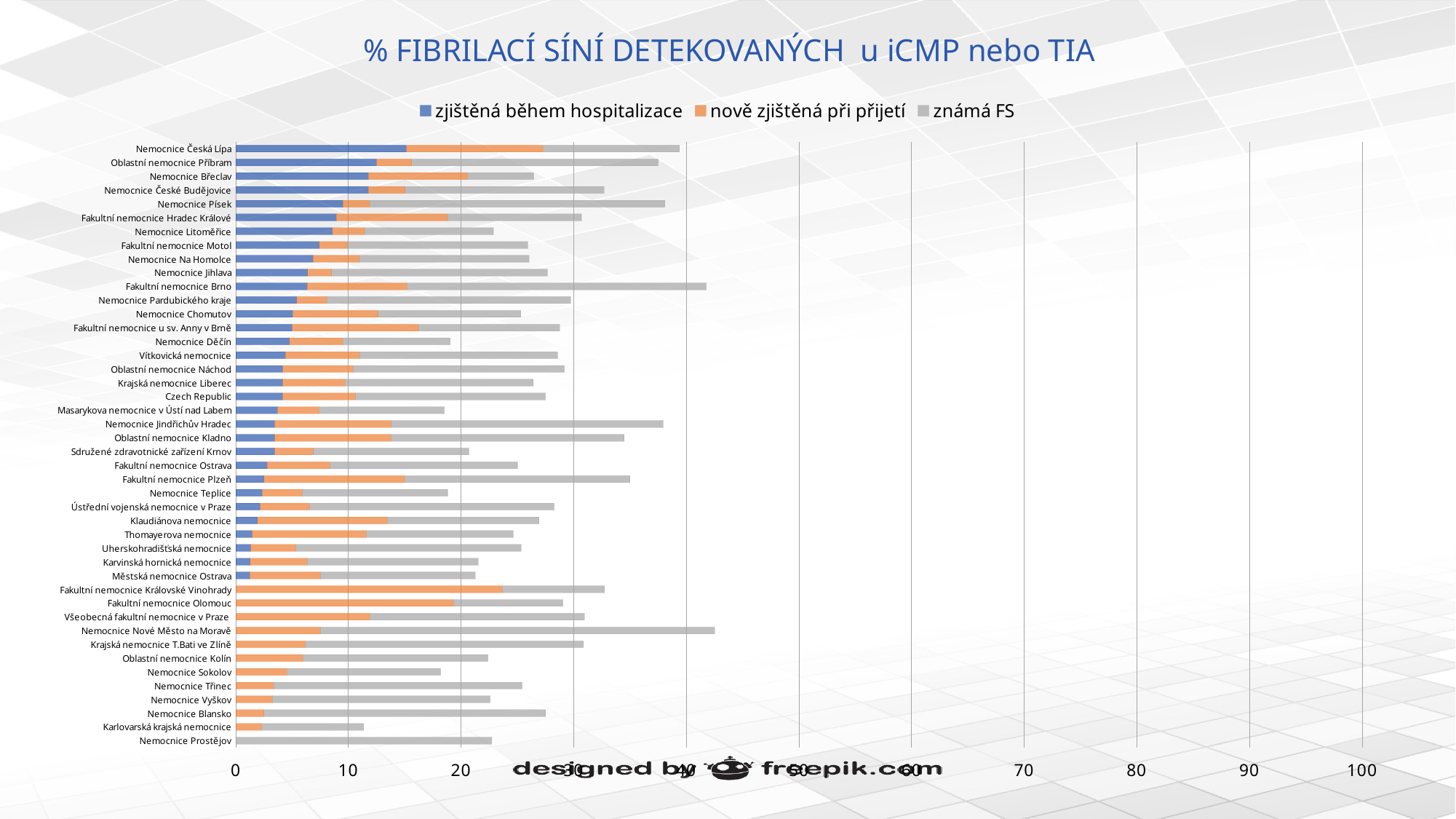
Is the blue 'zjištěná během hospitalizace' value for Nemocnice Česká Lípa greater or less than 10? greater Which category has the shortest total bar? Karlovarská krajská nemocnice Which has the longer total bar, Nemocnice Česká Lípa or Nemocnice Děčín? Nemocnice Česká Lípa What kind of chart is shown on the slide? Bar chart How many series does the legend list? 3 Is the total bar for Fakultní nemocnice Brno greater or less than 40? greater Which category has the longest blue 'zjištěná během hospitalizace' segment? Nemocnice Česká Lípa Is the total bar for Karlovarská krajská nemocnice greater or less than 20? less What is the title of the chart? % FIBRILACÍ SÍNÍ DETEKOVANÝCH u iCMP nebo TIA Which series is shown in grey in the legend? známá FS How many hospitals (categories) are plotted on the chart? 44 Which has the longer total bar, Nemocnice Nové Město na Moravě or Nemocnice Sokolov? Nemocnice Nové Město na Moravě